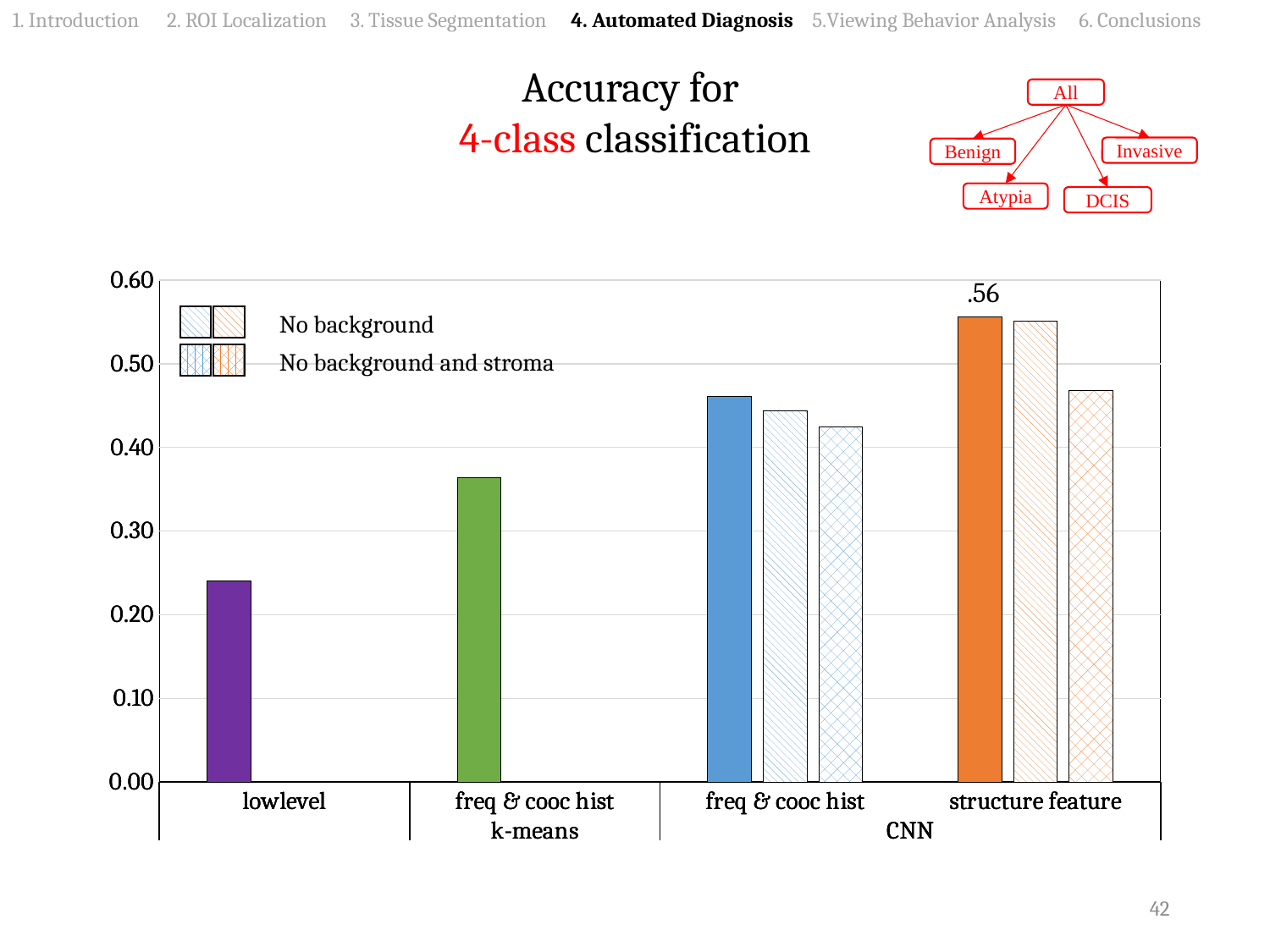
Do the solid bars rise or fall from left to right across the categories? rise Which category has the highest bar? structure feature Which is larger: the bar for lowlevel or the bar for freq & cooc hist under k-means? freq & cooc hist under k-means Which category has the lowest bar? lowlevel What value is labeled on the solid bar for structure feature? .56 Is the solid bar for freq & cooc hist under CNN greater or less than 0.40? greater What are the two legend entries shown in the chart? No background; No background and stroma Is the value for freq & cooc hist under k-means greater or less than 0.30? greater Is the value for lowlevel greater or less than 0.30? less How many categories are shown on the x axis? 4 What kind of chart is shown on the slide? bar chart